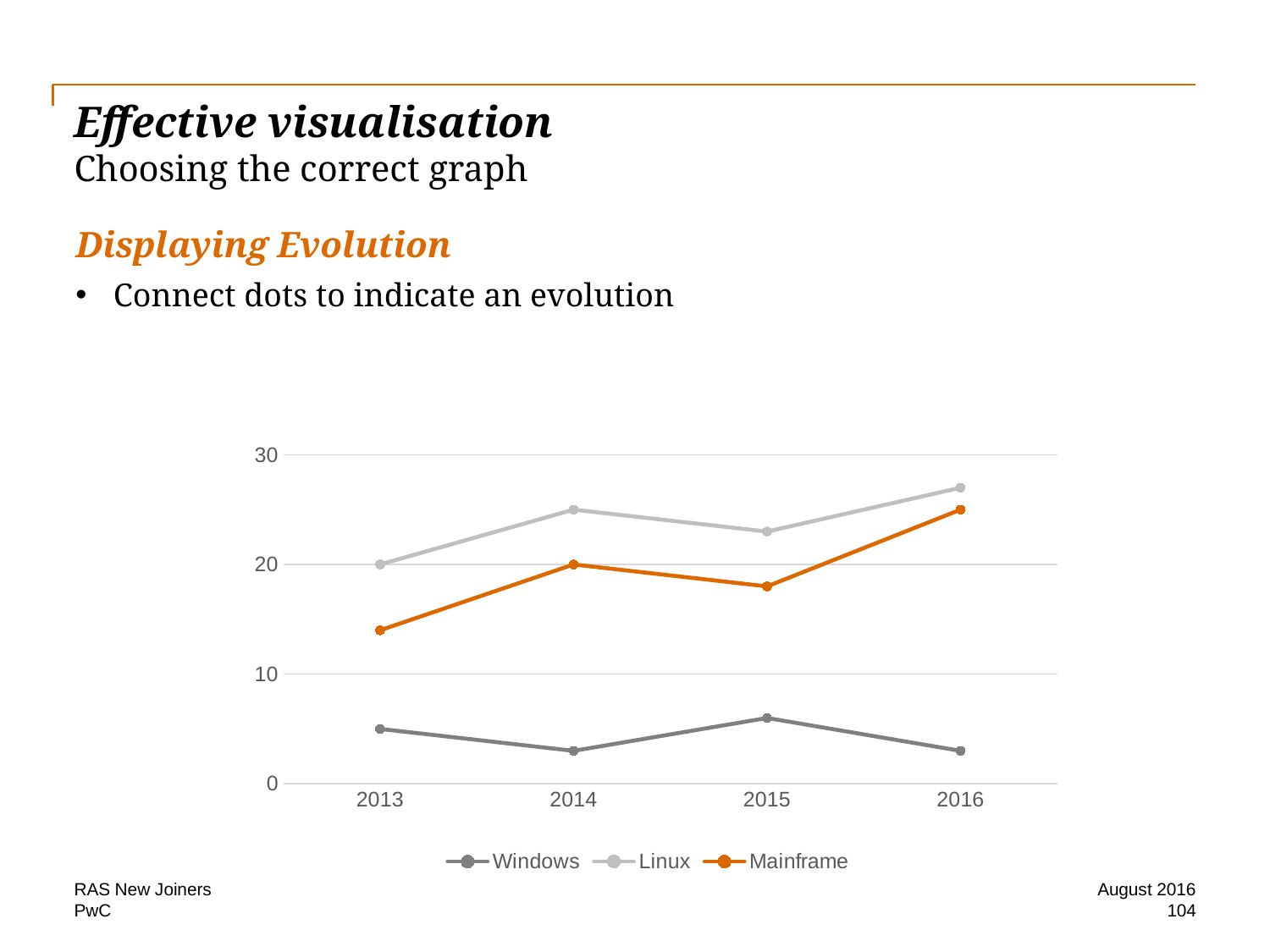
What kind of chart is shown on the slide? line chart Which series is drawn in orange? Mainframe Is the value for Mainframe in 2013 greater or less than 20? less What is the value for Mainframe in 2014? 20 How many series does the legend list? 3 Which is larger in 2015, the value for Linux or the value for Mainframe? Linux What is the value for Linux in 2013? 20 How many years are shown on the x axis? 4 Is the value for Mainframe in 2016 greater or less than 20? greater Which series has the highest value in 2016? Linux Is the value for Windows in 2015 greater or less than 10? less Which series has the lowest value in 2014? Windows